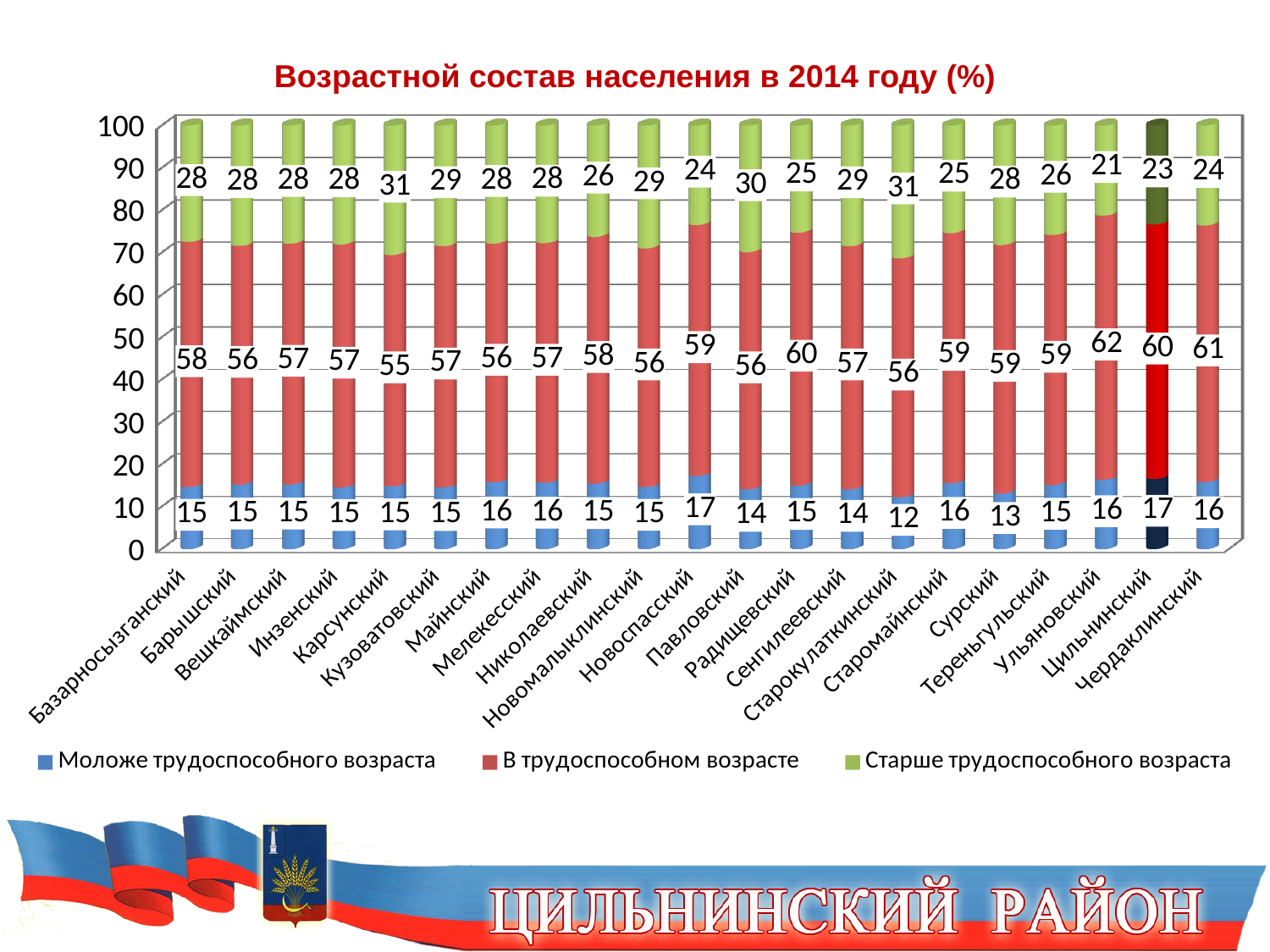
How many districts are shown on the x axis? 21 Which district has the lowest value for 'Старше трудоспособного возраста'? Ульяновский Which is larger: the 'Моложе трудоспособного возраста' value for Новоспасский or for Радищевский? Новоспасский Which district has the lowest value for 'В трудоспособном возрасте'? Карсунский What is the value for 'Моложе трудоспособного возраста' for Старокулаткинский? 12 Which district has the highest value for 'В трудоспособном возрасте'? Ульяновский What is the title of the chart? Возрастной состав населения в 2014 году (%) What is the value for 'В трудоспособном возрасте' for Цильнинский? 60 What type of chart is shown on the slide? stacked bar chart What is the difference between the 'Старше трудоспособного возраста' values for Старокулаткинский and Ульяновский? 10 How many series does the legend list? 3 What is the value for 'Старше трудоспособного возраста' for Карсунский? 31